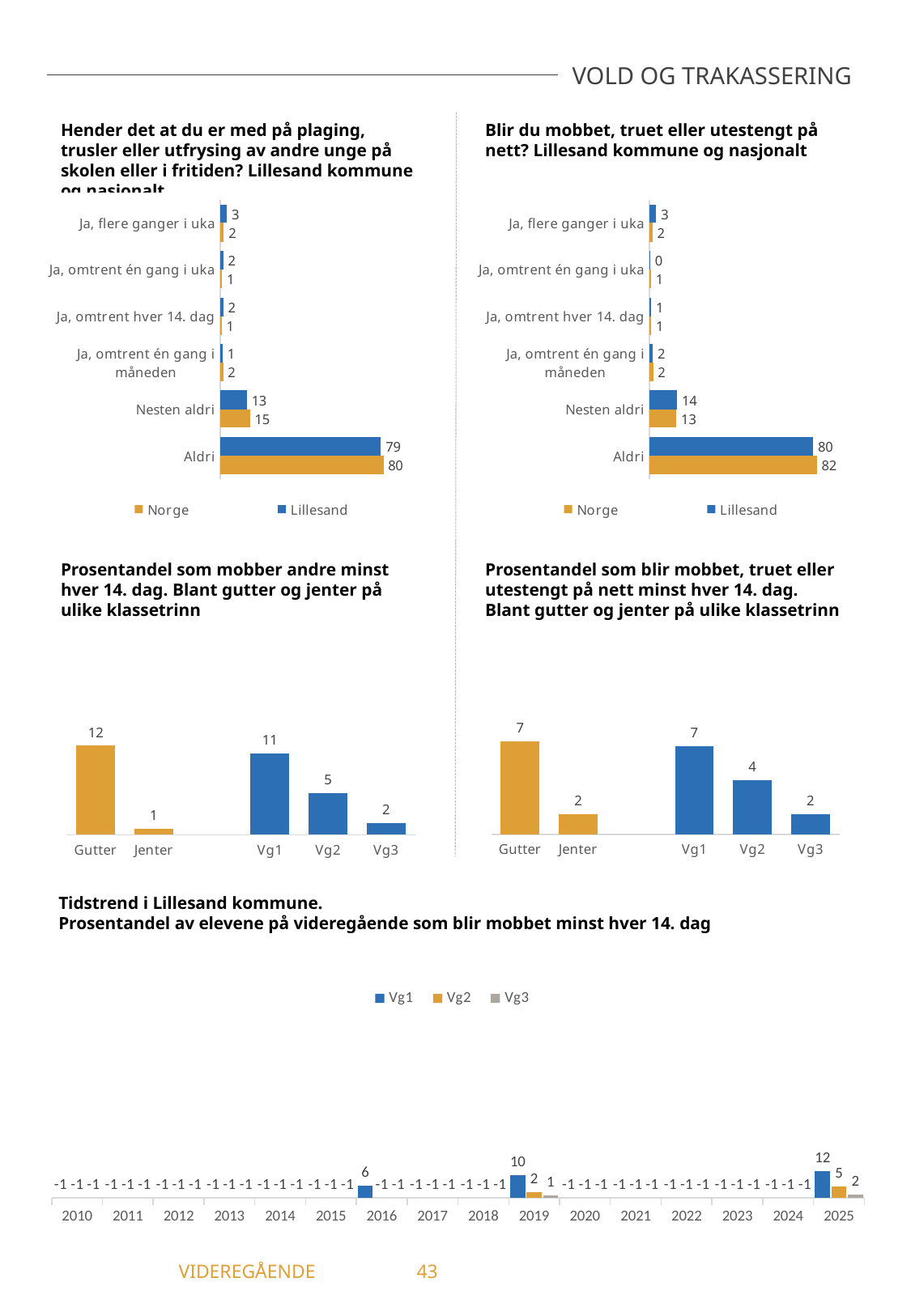
In the chart 'Prosentandel som blir mobbet, truet eller utestengt på nett minst hver 14. dag', what is the difference between Gutter and Jenter? 5 How many series does the legend list in the chart 'Blir du mobbet, truet eller utestengt på nett?'? 2 In the chart 'Hender det at du er med på plaging, trusler eller utfrysing av andre unge på skolen eller i fritiden?', what is the value for Lillesand in the 'Aldri' category? 79 In the chart 'Tidstrend i Lillesand kommune', what is the value for Vg1 in 2025? 12 In the chart 'Blir du mobbet, truet eller utestengt på nett?', what is the value for Norge in the 'Aldri' category? 82 In the chart 'Prosentandel som mobber andre minst hver 14. dag', what is the value for Vg2? 5 In the chart 'Tidstrend i Lillesand kommune', how many series does the legend list? 3 What kind of chart is the 'Tidstrend i Lillesand kommune' chart at the bottom of the slide? Bar chart In the chart 'Prosentandel som blir mobbet, truet eller utestengt på nett minst hver 14. dag', which category has the lowest value among Vg1, Vg2 and Vg3? Vg3 In the chart 'Hender det at du er med på plaging, trusler eller utfrysing av andre unge på skolen eller i fritiden?', what is the difference between Norge and Lillesand for 'Nesten aldri'? 2 In the chart 'Prosentandel som mobber andre minst hver 14. dag', which category has the highest value? Gutter In the chart 'Blir du mobbet, truet eller utestengt på nett?', which is larger for 'Nesten aldri': Norge or Lillesand? Lillesand